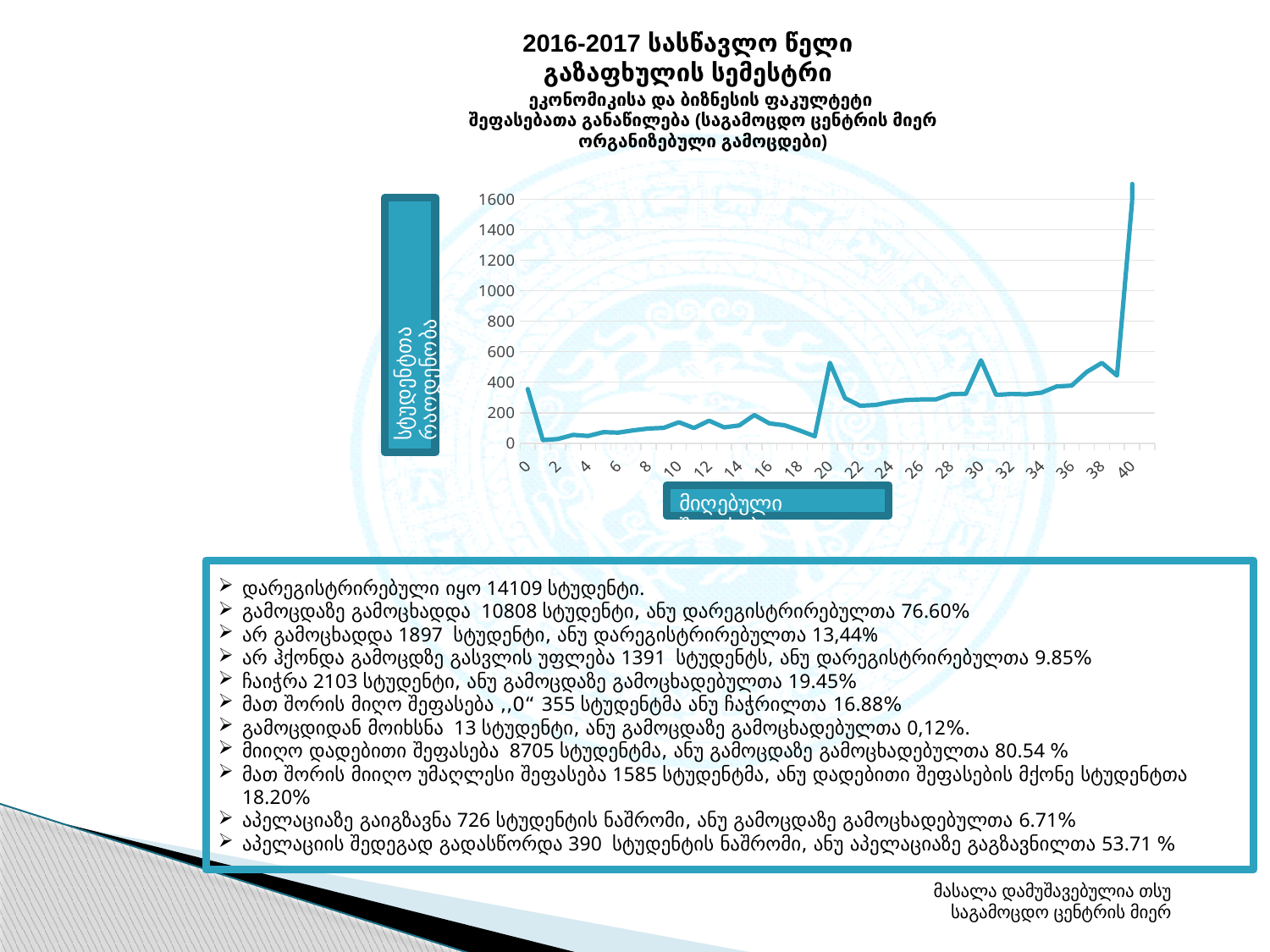
Does the line rise or fall between score 38 and score 40? rise Is the value at score 0 greater or less than 400? less Which has the larger value, score 40 or score 20? 40 Which has the larger value, score 20 or score 10? 20 What kind of chart is shown on the slide? line chart Is the value at score 10 greater or less than 200? less Is the value at score 30 greater or less than 400? greater At which score on the x axis does the line reach its highest value? 40 What is the highest tick value shown on the y axis? 1600